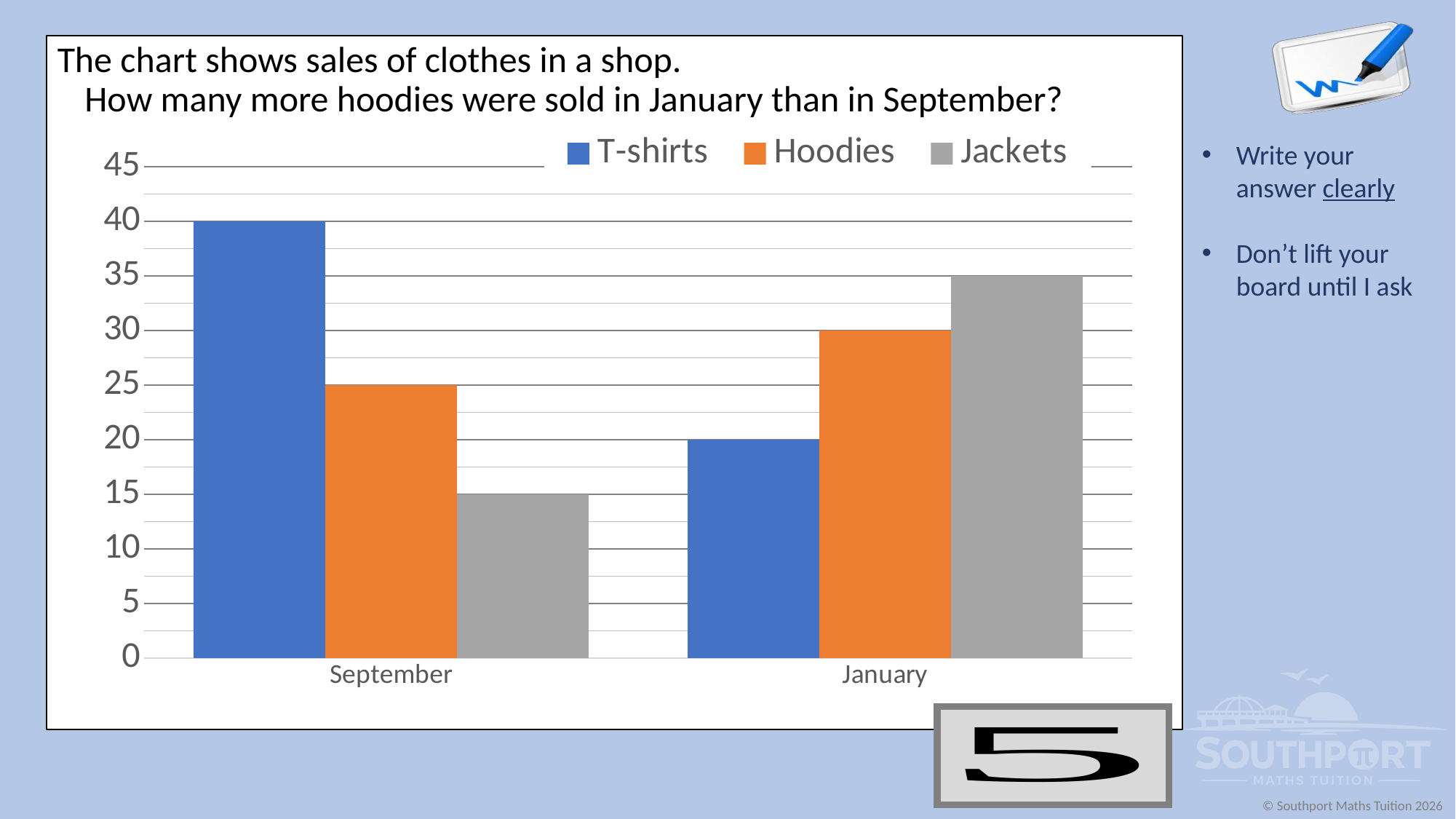
How many categories are shown on the x axis? 2 What is the difference between T-shirt sales in September and January? 20 How many T-shirts were sold in September? 40 How many more hoodies were sold in January than in September? 5 Which colour represents Hoodies in the legend? orange What kind of chart is shown on the slide? bar chart How many series does the legend list? 3 How many hoodies were sold in January? 30 How many jackets were sold in September? 15 Which item had the lowest sales in September? Jackets Which item had the highest sales in January? Jackets Were more T-shirts sold in September or in January? September